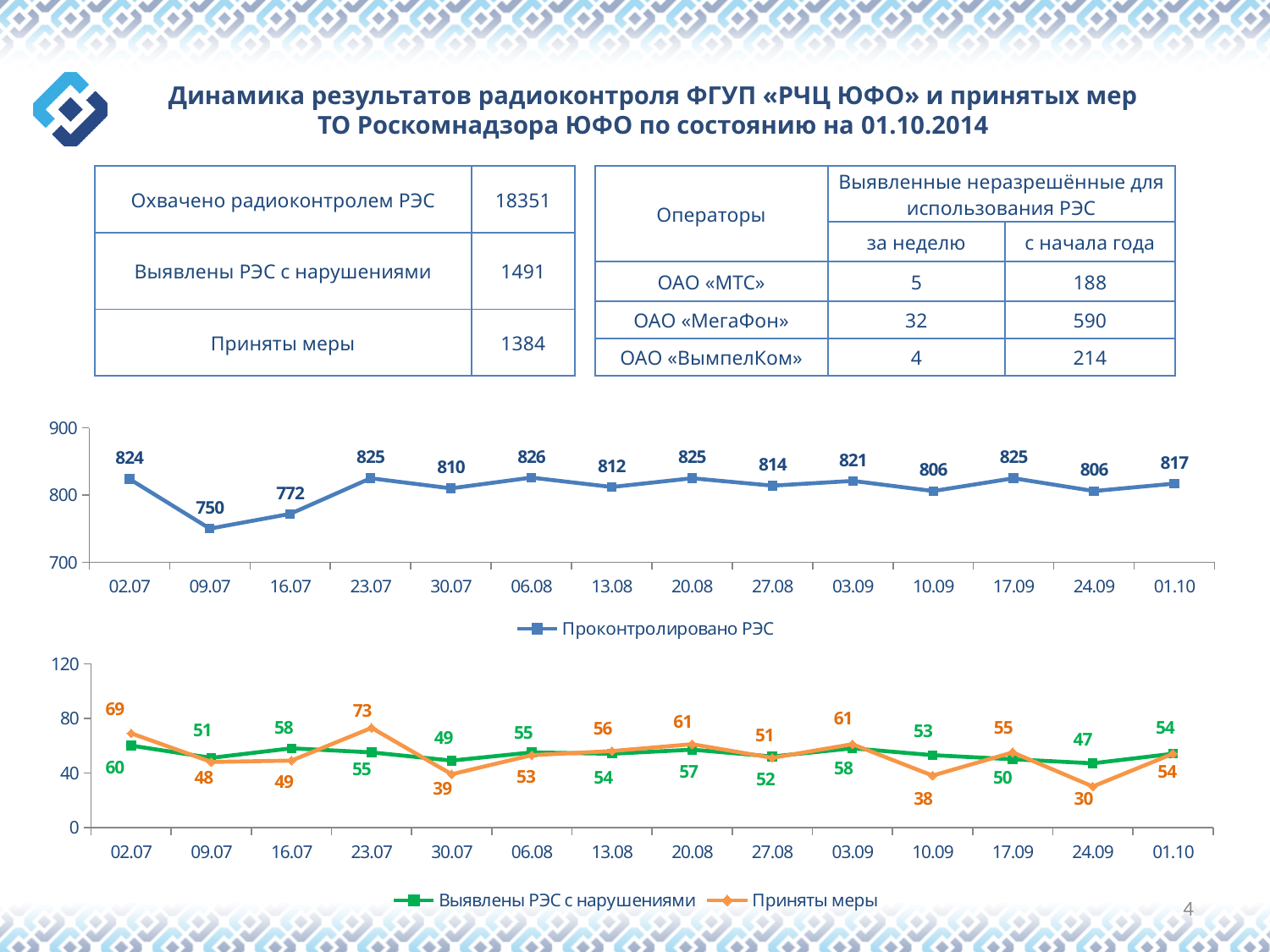
In the bottom chart, what is the difference between Приняты меры and Выявлены РЭС с нарушениями on 02.07? 9 In the bottom chart, on which date is the value for Приняты меры lowest? 24.09 In the top chart, on which date is the value for Проконтролировано РЭС lowest? 09.07 In the bottom chart, what is the value for Выявлены РЭС с нарушениями on 24.09? 47 In the top chart, what is the value for Проконтролировано РЭС on 09.07? 750 How many series does the legend of the bottom chart list? 2 In the bottom chart, which is larger on 10.09: Выявлены РЭС с нарушениями or Приняты меры? Выявлены РЭС с нарушениями In the top chart, what is the value for Проконтролировано РЭС on 01.10? 817 In the bottom chart, what is the value for Приняты меры on 23.07? 73 What type of chart is the bottom chart? line chart In the top chart, what is the difference between the values on 02.07 and 09.07? 74 How many data points are plotted in the top chart? 14